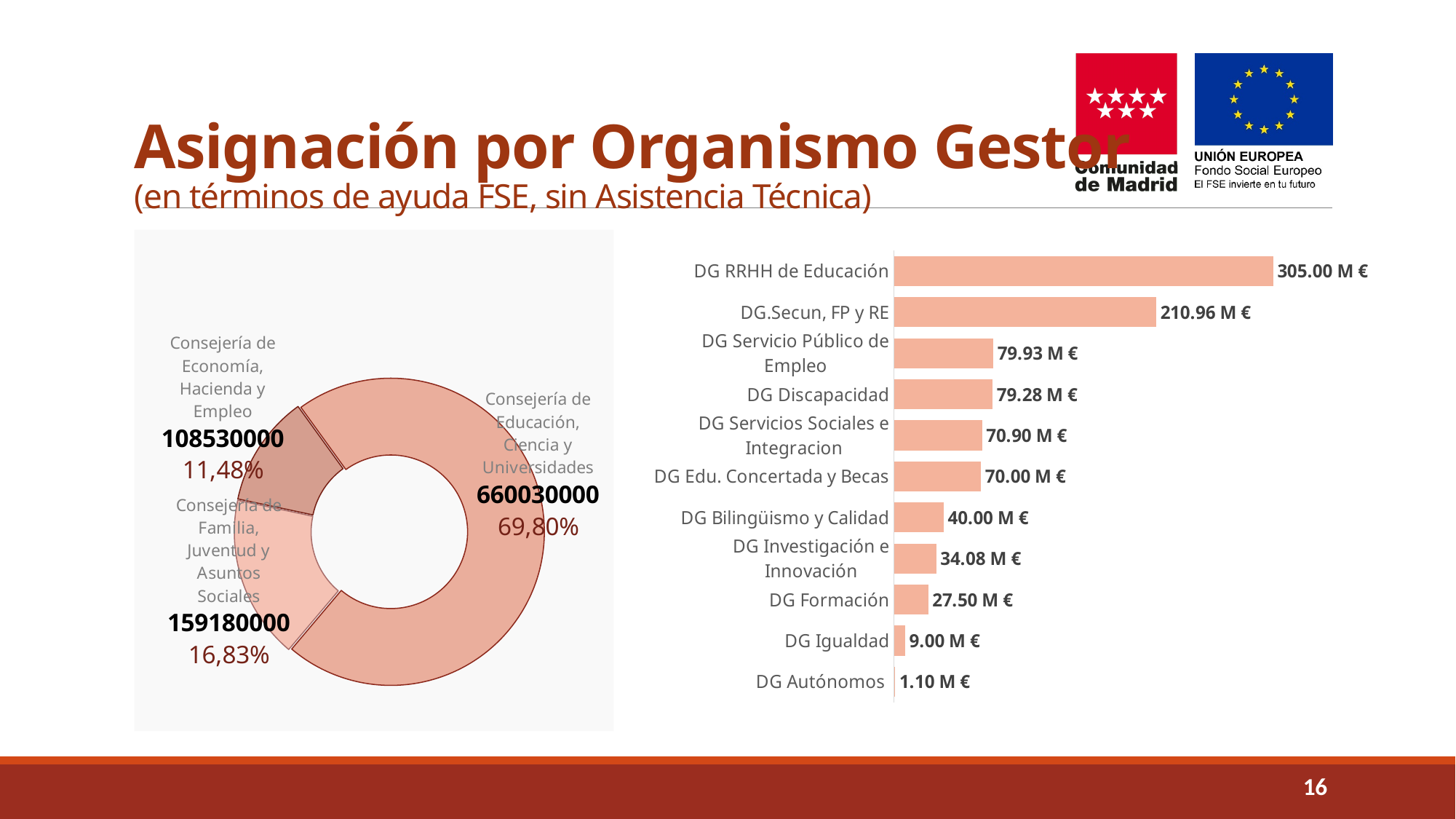
On the doughnut chart on the left, how many segments are there? 3 On the doughnut chart on the left, which segment is the smallest? Consejería de Economía, Hacienda y Empleo What kind of chart is on the right side of the slide? Bar chart On the bar chart on the right, what is the value for DG Bilingüismo y Calidad? 40.00 M € On the doughnut chart on the left, what share does Consejería de Educación, Ciencia y Universidades have? 69,80% On the doughnut chart on the left, what value is shown for Consejería de Familia, Juventud y Asuntos Sociales? 159180000 On the bar chart on the right, what is the value for DG RRHH de Educación? 305.00 M € On the bar chart on the right, what is the difference between DG RRHH de Educación and DG.Secun, FP y RE? 94.04 M € On the bar chart on the right, which category has the highest value? DG RRHH de Educación On the bar chart on the right, how many categories are shown? 11 On the bar chart on the right, which is larger: DG Formación or DG Igualdad? DG Formación On the bar chart on the right, which category has the lowest value? DG Autónomos